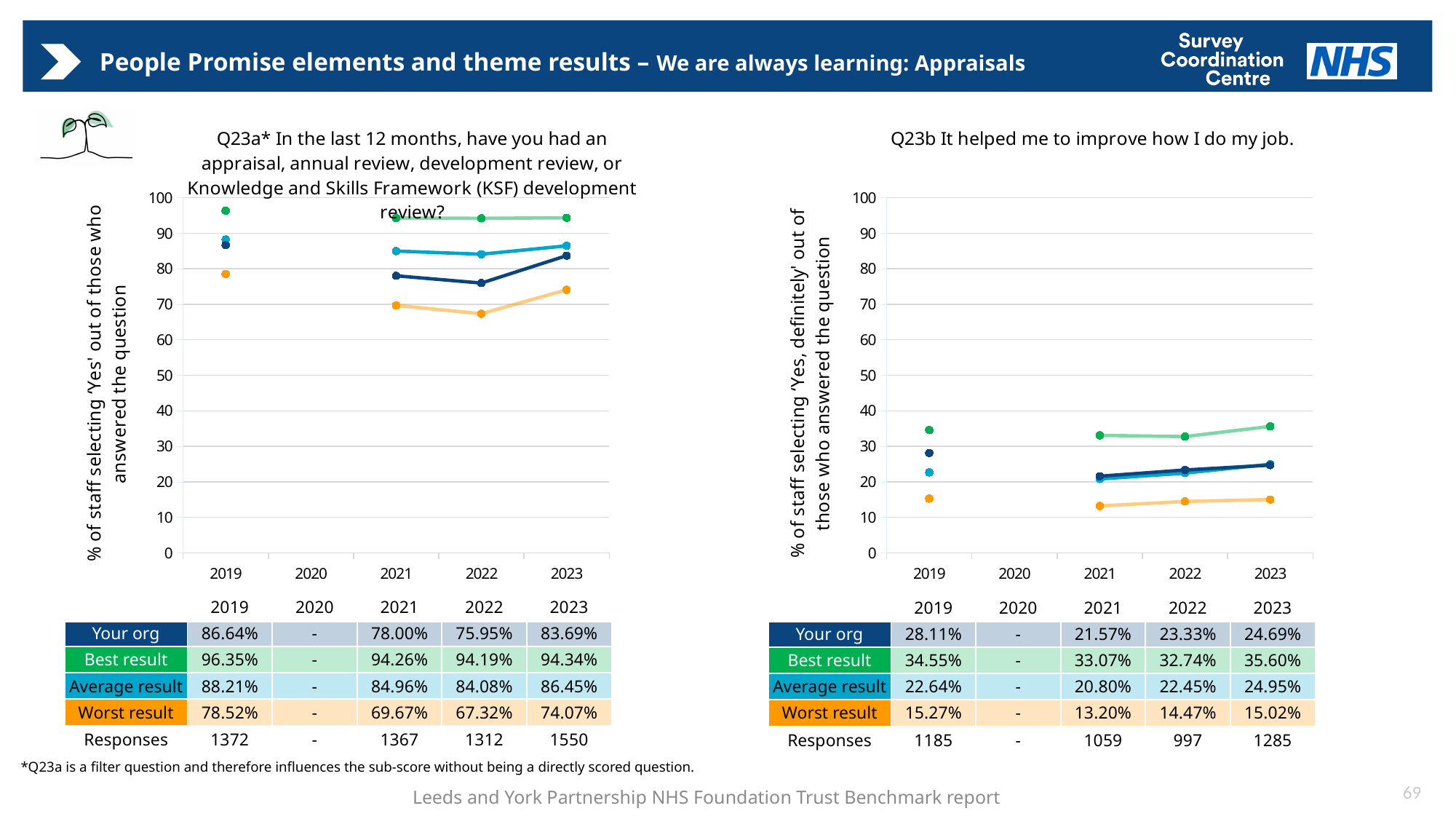
In the Q23b chart on the right, did the 'Worst result' value rise or fall from 2021 to 2023? Rise In the Q23b chart on the right, which is larger in 2023: 'Your org' or 'Average result'? Average result In the Q23a chart on the left, what was the 'Your org' value in 2023? 83.69% In the Q23a chart on the left, which year had the lowest 'Your org' value? 2022 In the Q23a chart on the left, what is the difference between the 'Best result' and 'Worst result' values in 2022? 26.87% In the Q23a chart on the left, how many responses were recorded in 2023? 1550 How many series are shown in the table below the Q23a chart on the left (excluding Responses)? 4 In the Q23b chart on the right, what was the 'Best result' value in 2021? 33.07% What kind of chart is the Q23b chart on the right? Line chart In the Q23b chart on the right, is the 'Best result' value for 2019 greater or less than 30? greater In the Q23b chart on the right, which year had the highest 'Best result' value? 2023 In the Q23a chart on the left, is the 'Worst result' value for 2021 greater or less than 70? less